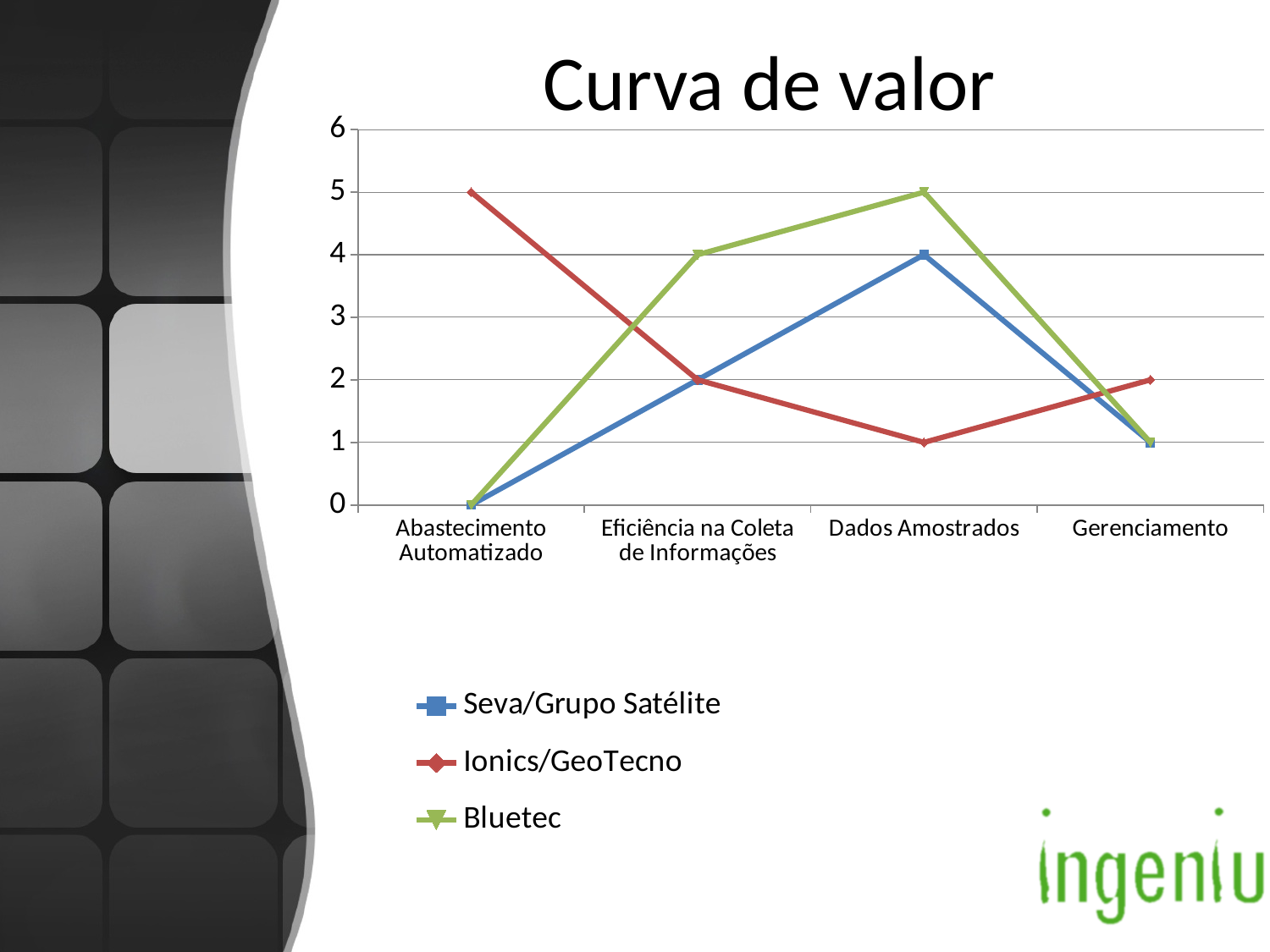
What is the value for Ionics/GeoTecno at Abastecimento Automatizado? 5 What is the difference between Bluetec and Seva/Grupo Satélite at Eficiência na Coleta de Informações? 2 Which is larger at Abastecimento Automatizado: Ionics/GeoTecno or Bluetec? Ionics/GeoTecno How many series does the legend list? 3 Which category has the lowest value for Ionics/GeoTecno? Dados Amostrados Which category has the highest value for Bluetec? Dados Amostrados What is the title of the chart? Curva de valor How many categories are shown on the x axis? 4 What is the value for Bluetec at Dados Amostrados? 5 What kind of chart is shown on the slide? line chart What is the value for Seva/Grupo Satélite at Dados Amostrados? 4 What is the value for Ionics/GeoTecno at Gerenciamento? 2